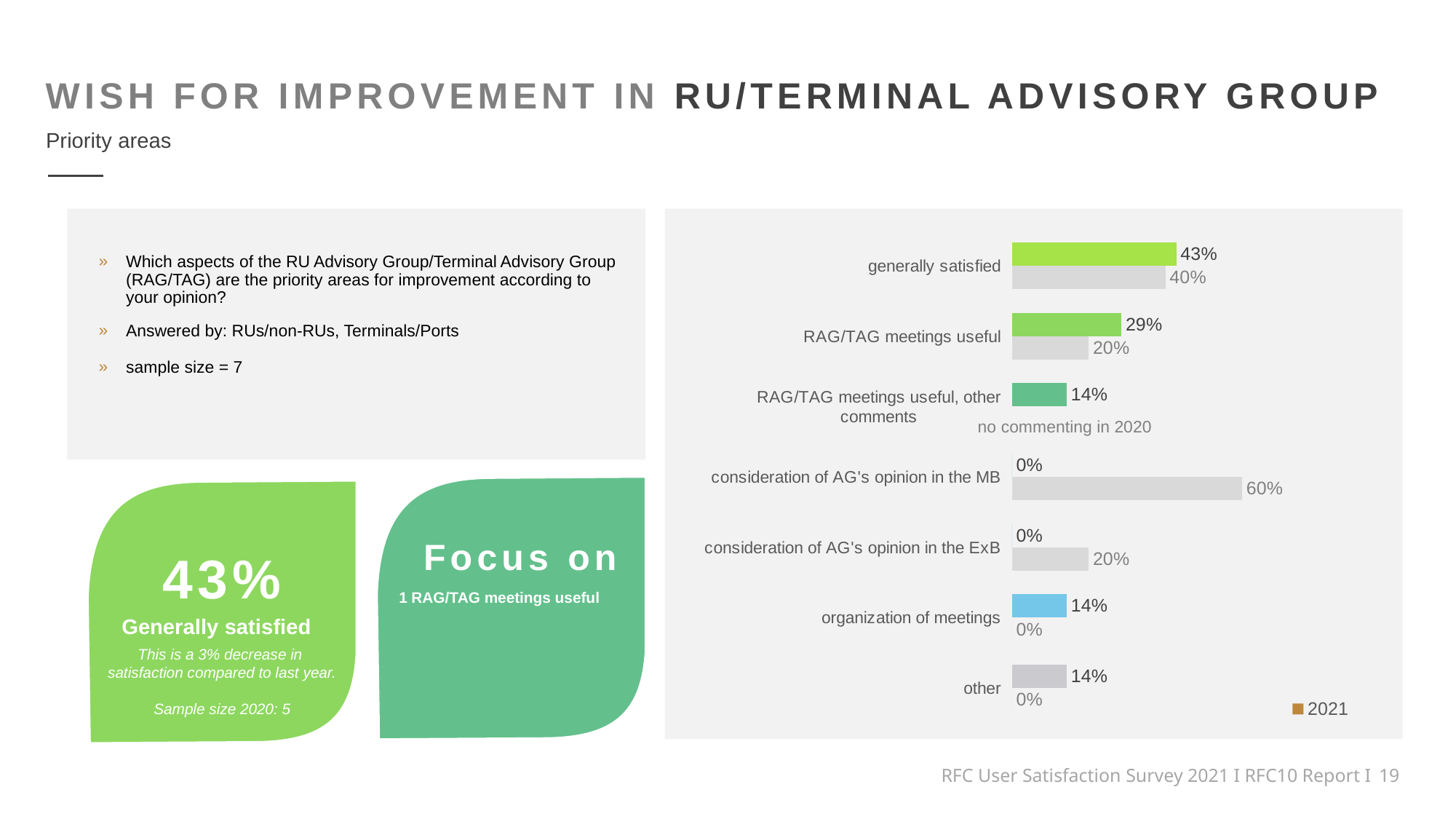
Which category has the highest 2021 value? generally satisfied What is the difference between the 2021 and 2020 values for "generally satisfied"? 3% Which category has the highest 2020 value? consideration of AG's opinion in the MB What is the 2020 value for "RAG/TAG meetings useful"? 20% What is written in place of a 2020 bar for "RAG/TAG meetings useful, other comments"? no commenting in 2020 Which is larger for "RAG/TAG meetings useful": the 2021 value or the 2020 value? 2021 How many categories are shown on the chart? 7 What is the 2021 value for "RAG/TAG meetings useful"? 29% What is the 2021 value for "generally satisfied"? 43% What is the difference between the 2020 and 2021 values for "consideration of AG's opinion in the MB"? 60% What is the 2020 value for "consideration of AG's opinion in the MB"? 60% What type of chart is shown on the slide? bar chart